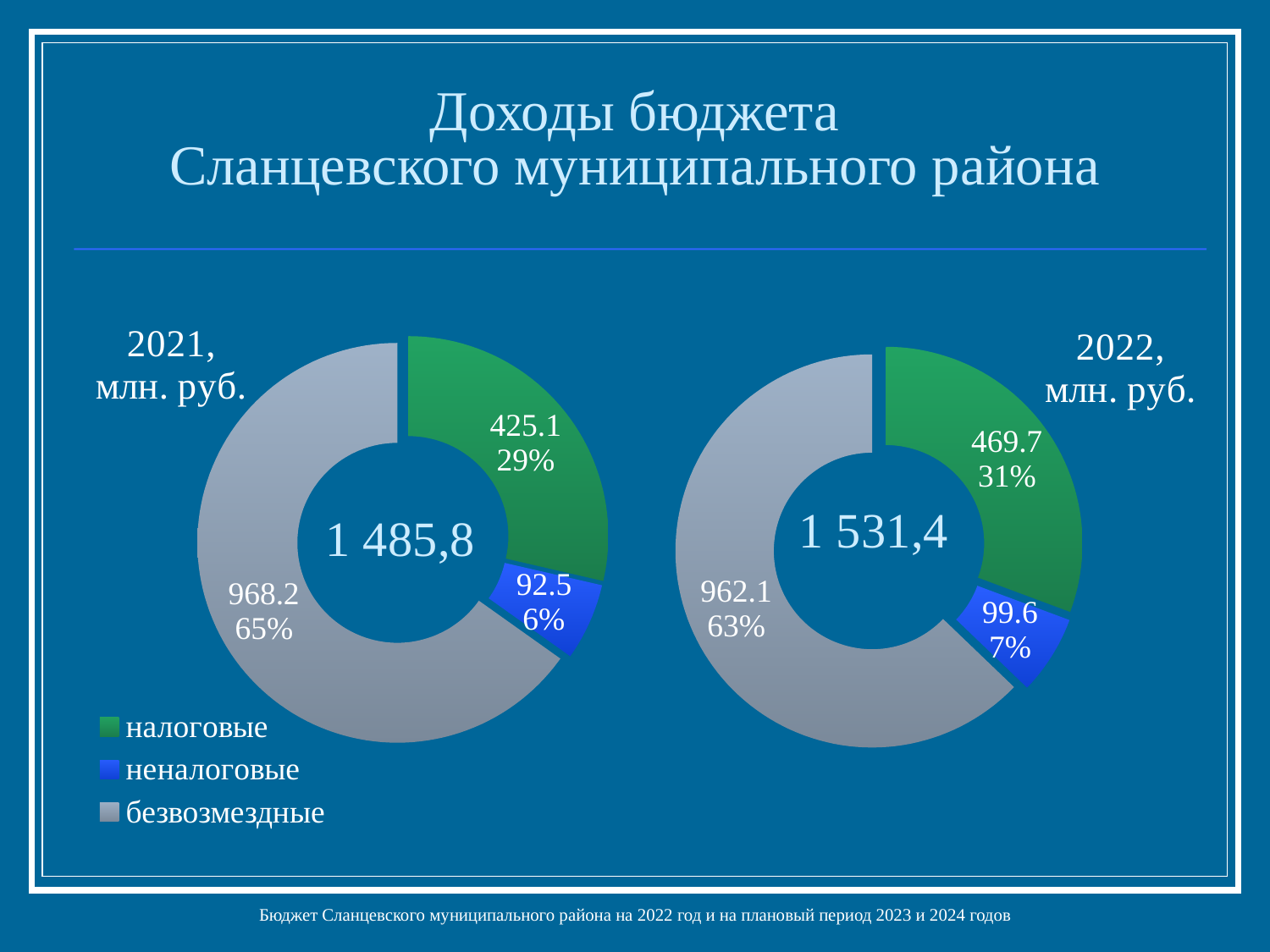
In the 2021 chart, which category has the largest value? безвозмездные In the 2021 chart, what is the value for налоговые? 425.1 Which is larger: налоговые in the 2021 chart or налоговые in the 2022 chart? 2022 In the 2022 chart, what is the value for неналоговые? 99.6 In the 2021 chart, what is the difference between безвозмездные and налоговые? 543.1 How many categories does the 2022 chart show? 3 In the 2022 chart, what is the value for безвозмездные? 962.1 In the 2022 chart, what share of the total do налоговые make up? 31% What total value is printed in the centre of the 2022 chart? 1 531,4 What kind of chart is the 2021 chart? doughnut chart In the 2021 chart, what share of the total do безвозмездные make up? 65% In the 2022 chart, which category has the smallest value? неналоговые